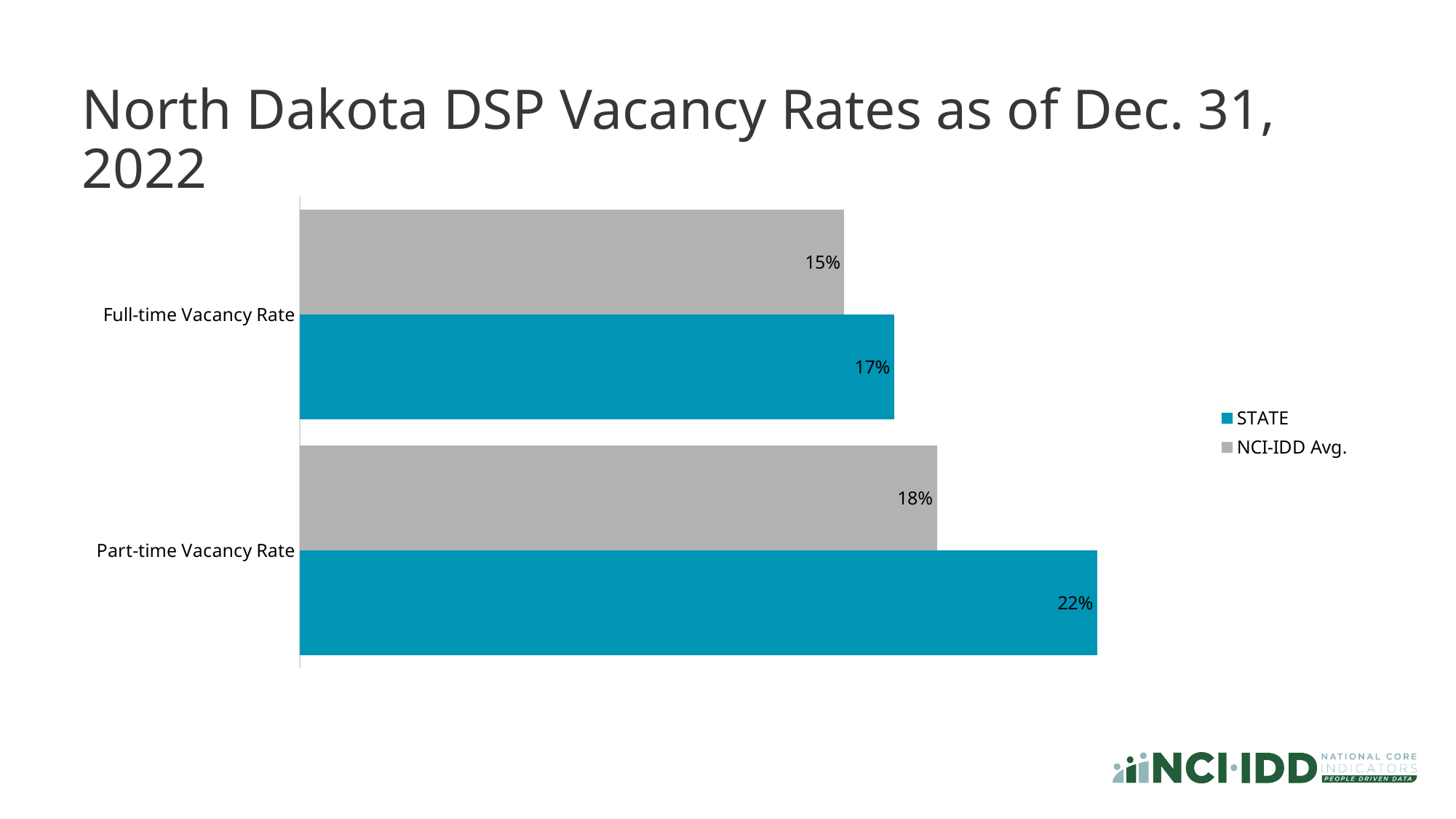
What is the NCI-IDD Avg. value for Full-time Vacancy Rate? 15% Which category has the highest STATE value? Part-time Vacancy Rate What kind of chart is shown on the slide? Bar chart Which is larger for Full-time Vacancy Rate: the STATE value or the NCI-IDD Avg. value? STATE What is the difference between the STATE and NCI-IDD Avg. values for Full-time Vacancy Rate? 2% What is the NCI-IDD Avg. value for Part-time Vacancy Rate? 18% What is the difference between the STATE and NCI-IDD Avg. values for Part-time Vacancy Rate? 4% How many categories are shown on the chart? 2 What is the STATE value for Part-time Vacancy Rate? 22% How many series does the legend list? 2 Which category has the lowest NCI-IDD Avg. value? Full-time Vacancy Rate What is the STATE value for Full-time Vacancy Rate? 17%